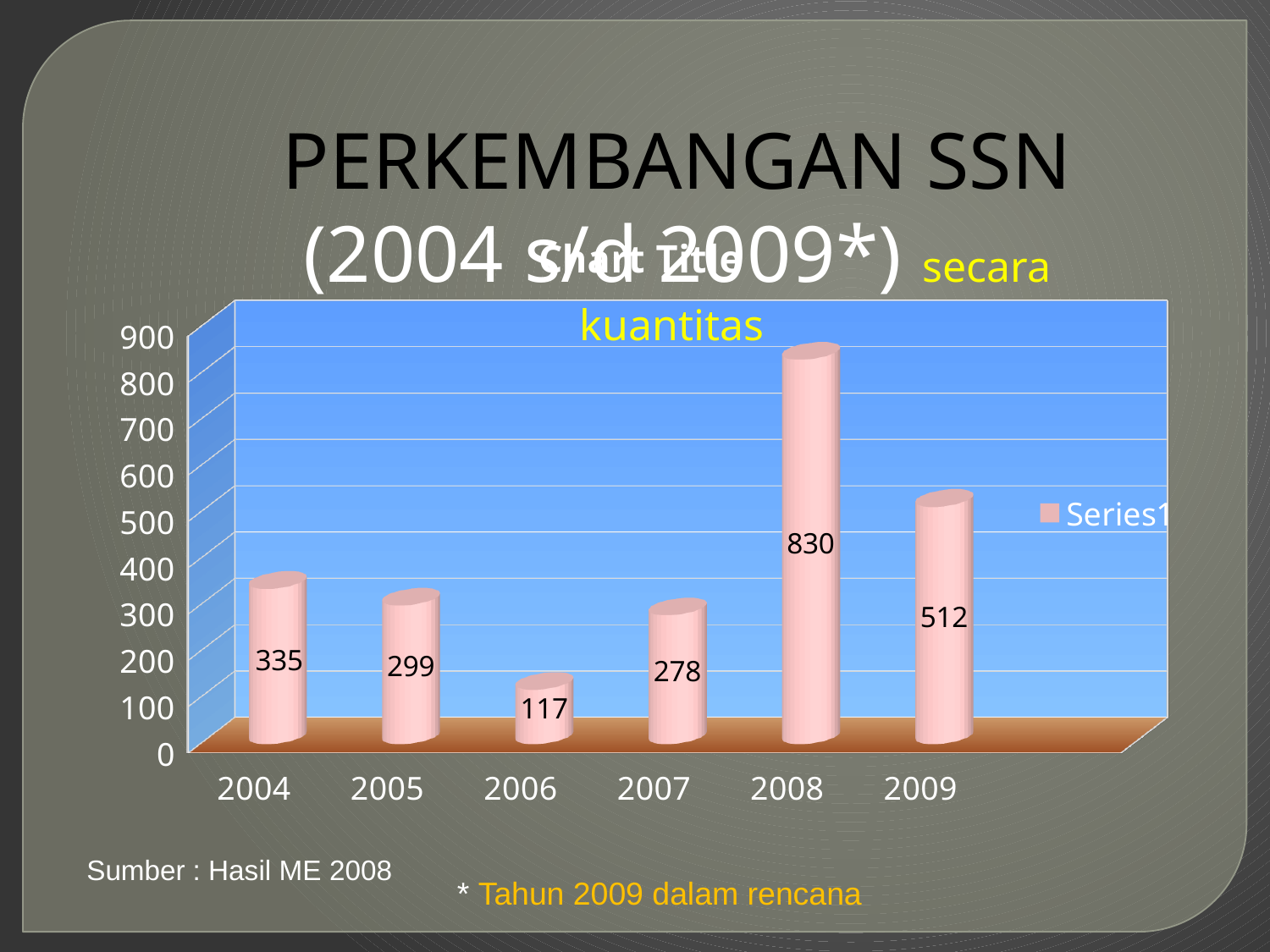
What kind of chart is shown on the slide? bar chart Is the value for 2008 greater or less than 800? greater What is the value for 2004? 335 Which year has the lowest value? 2006 What series name is listed in the legend? Series1 What is the difference between the values for 2004 and 2005? 36 How many years are shown on the x axis? 6 Which year has the highest value? 2008 What is the value for 2008? 830 What is the difference between the values for 2008 and 2009? 318 Which is larger, the value for 2007 or the value for 2009? 2009 What is the value for 2006? 117